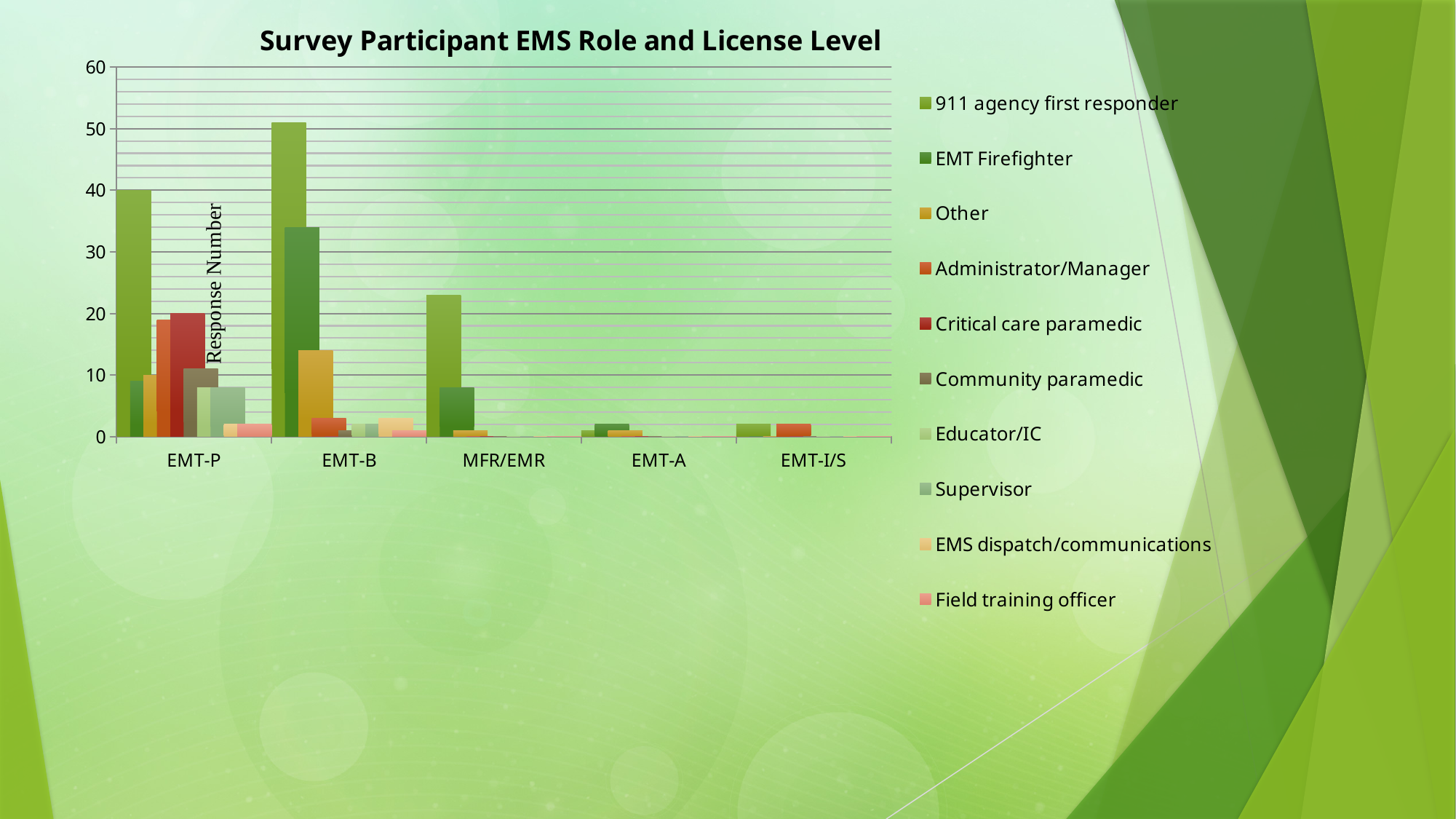
Which is larger: the EMT Firefighter value for EMT-P or for EMT-B? EMT-B What is the title of the chart? Survey Participant EMS Role and License Level What kind of chart is shown on the slide? bar chart How many license level categories are shown on the x axis? 5 Which license level category has the tallest bar in the chart? EMT-B Is the value for Other in the EMT-B category greater or less than 10? greater How many series does the legend list? 10 What is the label on the vertical axis? Response Number Which series has the highest value in the EMT-P category? 911 agency first responder Is the value for 911 agency first responder in the MFR/EMR category greater or less than 20? greater Is the value for EMT Firefighter in the EMT-B category greater or less than 30? greater